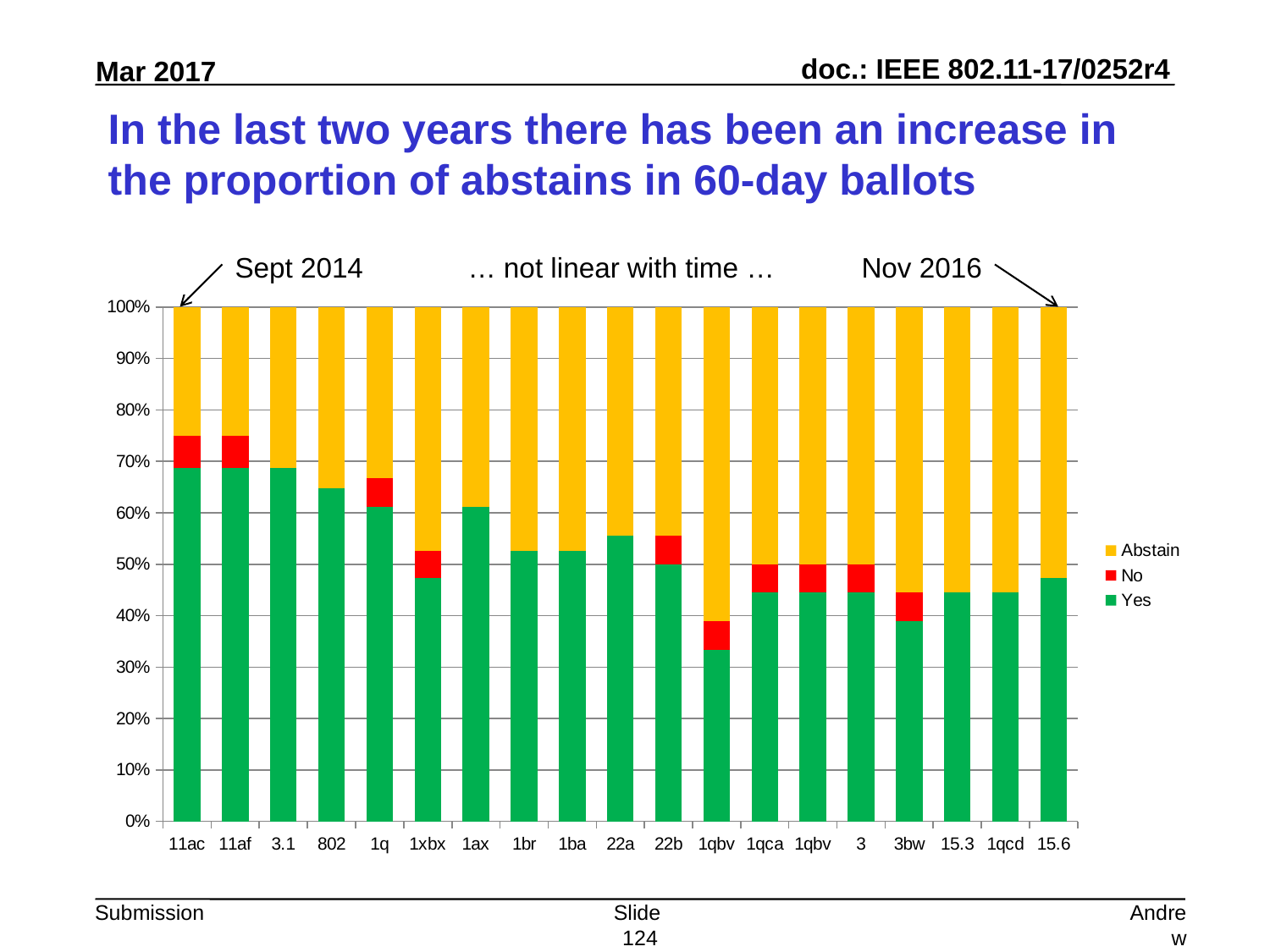
What does each stacked bar total? 100% Is the Yes share for 11ac greater or less than 60%? greater Does the Yes share generally rise or fall moving from left to right along the x axis? fall Is the Yes share for 22a greater or less than 50%? greater Is the Yes share for 15.6 greater or less than 50%? less Which colour represents Abstain in the legend? yellow What kind of chart is shown on the slide? stacked bar chart Which category has the lowest Yes share? 1qbv How many series does the legend list? 3 How many ballot categories are shown along the x axis? 19